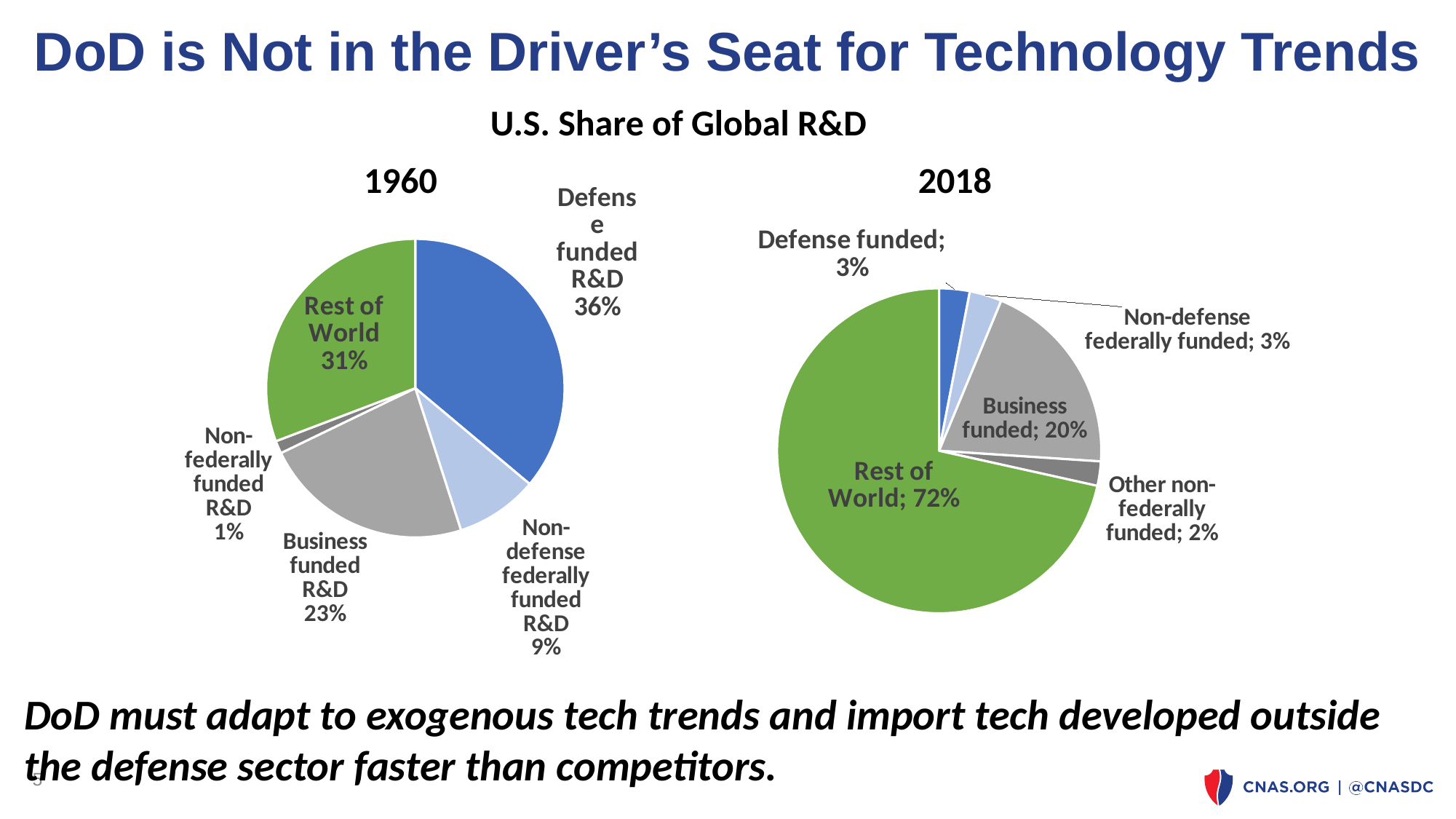
In the 2018 pie chart, which category has the largest share? Rest of World In the 1960 pie chart, what share is Business funded R&D? 23% In the 2018 pie chart, which category has the smallest share? Other non-federally funded In the 1960 pie chart, what share is Defense funded R&D? 36% In the 1960 pie chart, which category has the smallest share? Non-federally funded R&D In the 1960 pie chart, which category has the largest share? Defense funded R&D What type of chart is used for the 1960 and 2018 data? Pie chart In the 1960 pie chart, which is larger: Rest of World or Business funded R&D? Rest of World In the 2018 pie chart, what share is Rest of World? 72% What is the difference between the Defense funded share in 1960 and in 2018? 33 percentage points In the 2018 pie chart, what share is Business funded? 20% How many slices does the 2018 pie chart have? 5